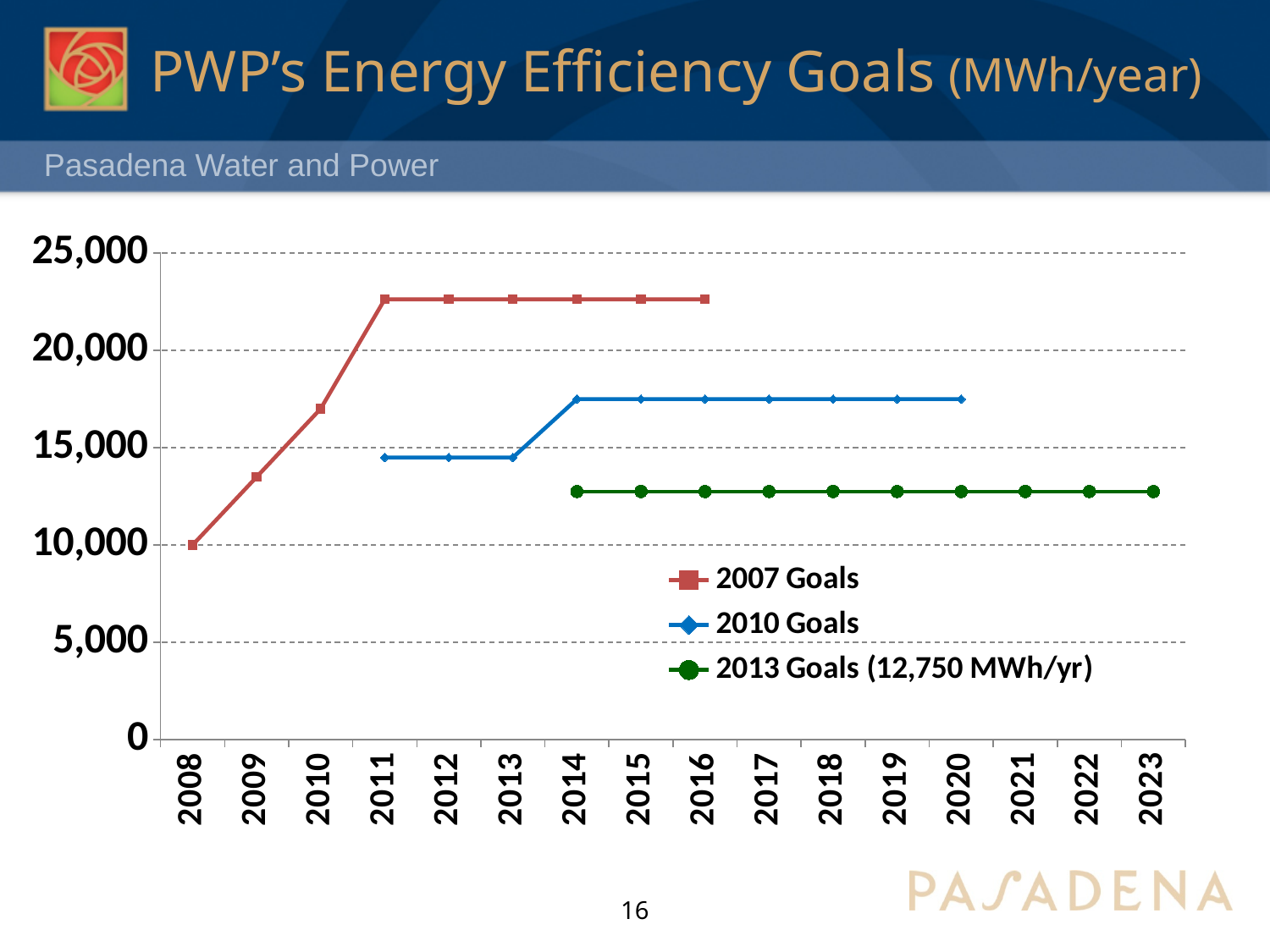
What is the value of the 2007 Goals series in 2008? 10,000 How many series does the legend list? 3 In 2014, which series has the larger value: 2007 Goals or 2010 Goals? 2007 Goals Is the value for 2010 Goals in 2015 greater or less than 15,000? greater Is the value for 2010 Goals in 2012 greater or less than 15,000? less In 2016, which series has the larger value: 2010 Goals or 2013 Goals? 2010 Goals What is the annual value of the 2013 Goals series, as stated in the legend? 12,750 MWh/yr Which series has the highest value in 2015? 2007 Goals Is the value for 2007 Goals in 2012 greater or less than 20,000? greater How many years are shown on the x axis? 16 What kind of chart is shown on the slide? line chart Does the 2007 Goals series rise or fall from 2008 to 2011? rise